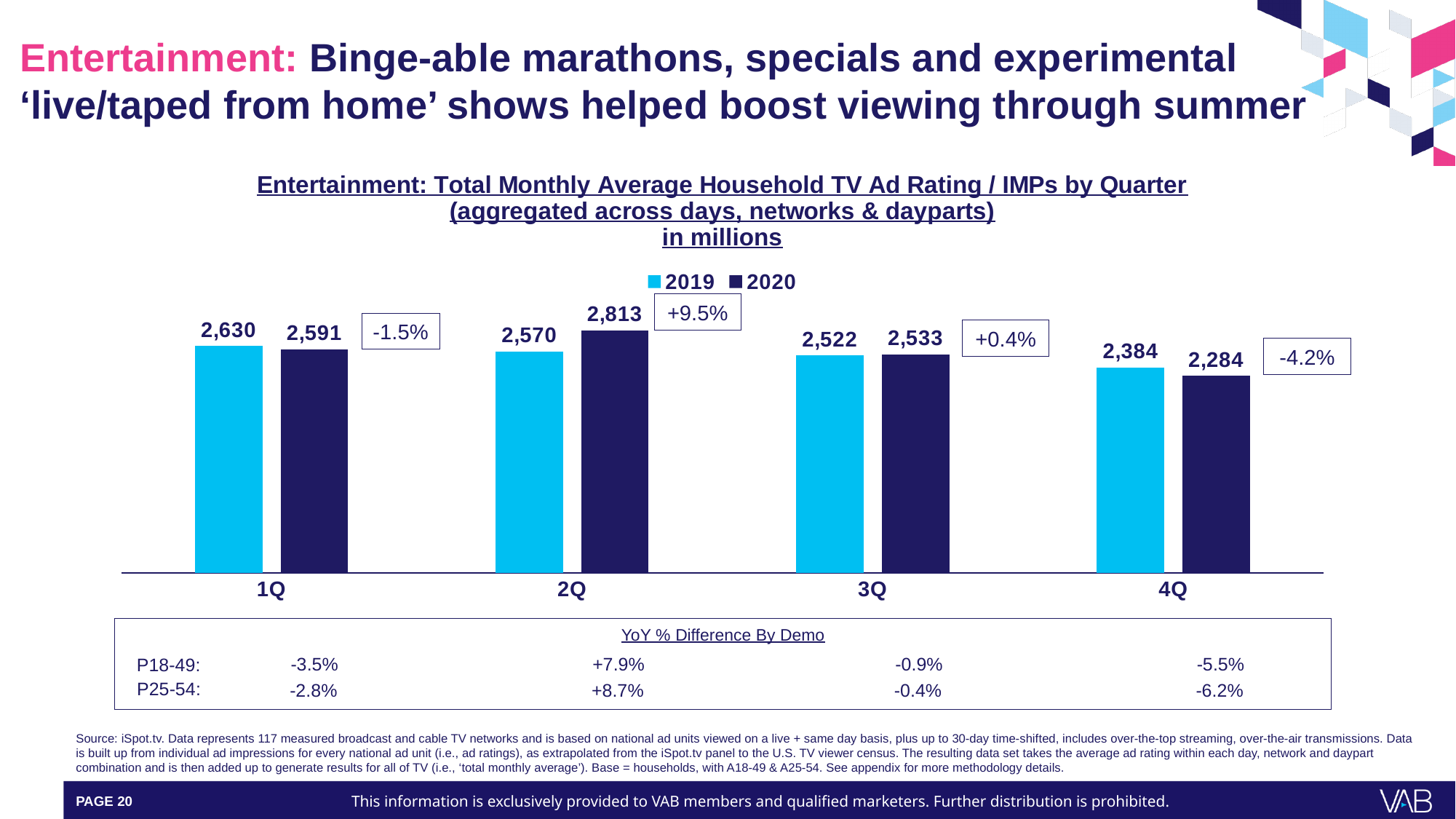
How many series does the legend list? 2 Which quarter has the lowest 2019 value? 4Q What is the difference between the 2020 and 2019 values for 2Q? 243 What is the 2020 value for 2Q? 2,813 Which is larger for 1Q, the 2019 value or the 2020 value? 2019 How many quarters are shown on the x axis? 4 What is the difference between the 2019 and 2020 values for 4Q? 100 What is the 2020 value for 4Q? 2,284 What is the 2019 value for 1Q? 2,630 What year-over-year percentage change is labelled for 3Q? +0.4% What kind of chart is shown? Bar chart Which quarter has the highest 2020 value? 2Q